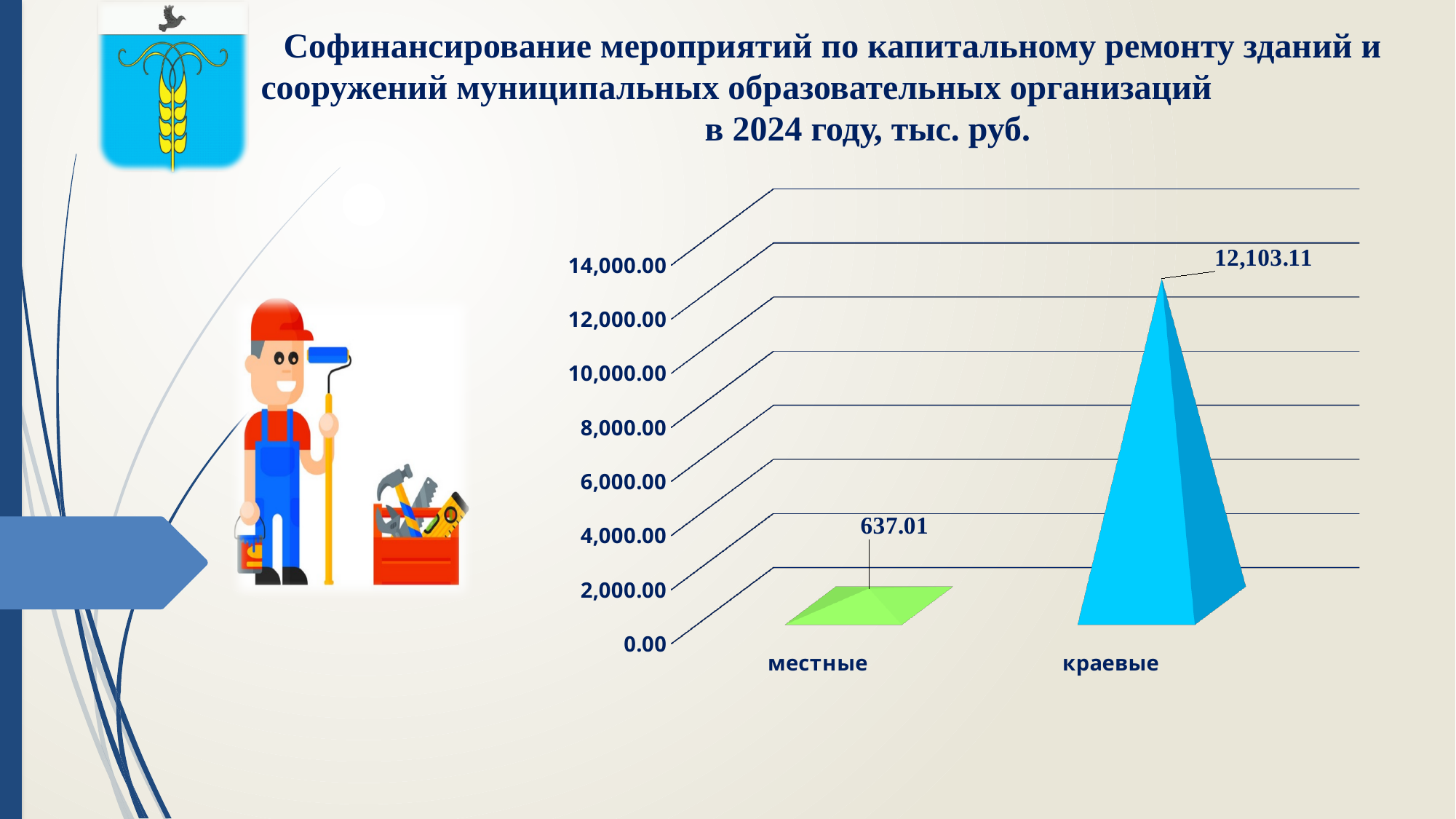
What is the difference between the values for краевые and местные? 11,466.10 Is the value for местные greater or less than 2,000.00? less What is the highest value shown on the vertical axis of the chart? 14,000.00 Which category has the highest value? краевые What is the value for краевые? 12,103.11 What kind of chart is shown on the slide? bar chart How many categories are shown on the chart? 2 Which is larger, the value for местные or the value for краевые? краевые What is the total of the values for местные and краевые? 12,740.12 Is the value for краевые greater or less than 10,000.00? greater What is the value for местные? 637.01 Which category has the lowest value? местные